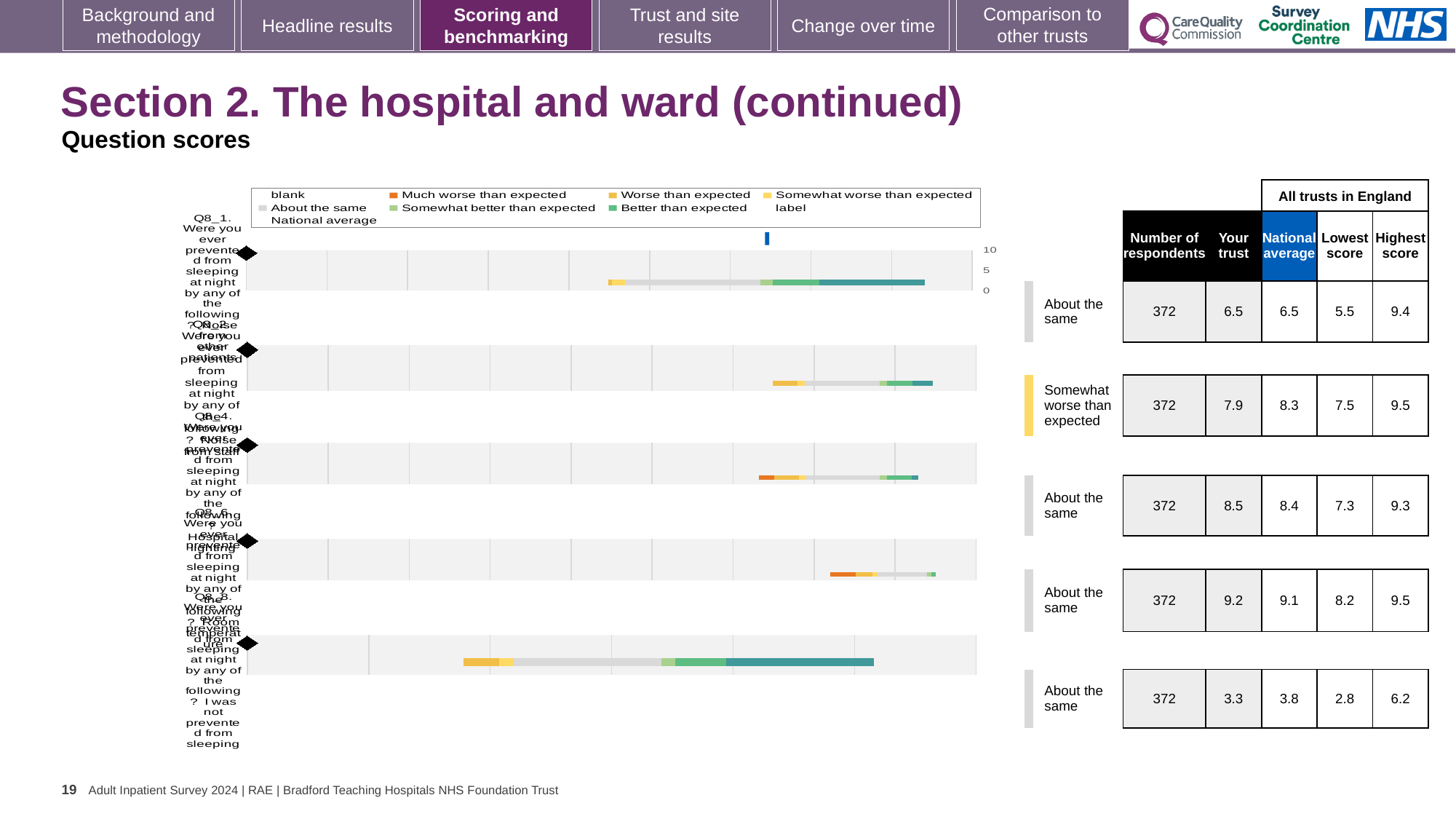
What benchmark category is shown for the second chart from the top (Q8_2)? Somewhat worse than expected For the top chart (Q8_1), what is the difference between the highest score and the lowest score across all trusts in England? 3.9 In the chart legend, which colour represents 'Better than expected'? teal How many respondents are listed for the top chart (Q8_1)? 372 For the top chart (Q8_1), what is the 'Your trust' score shown in the table? 6.5 Which chart has the highest 'Your trust' score? the fourth chart from the top (9.2) In the chart legend, which colour represents 'Much worse than expected'? orange How many question bars (charts) are shown on the slide? 5 What kind of chart is used to show the question scores on this slide? bar chart For the second chart from the top (Q8_2), what is the national average score? 8.3 For the second chart from the top (Q8_2), is the 'Your trust' score higher or lower than the national average? lower Which chart has the lowest 'Your trust' score? the bottom chart (3.3)